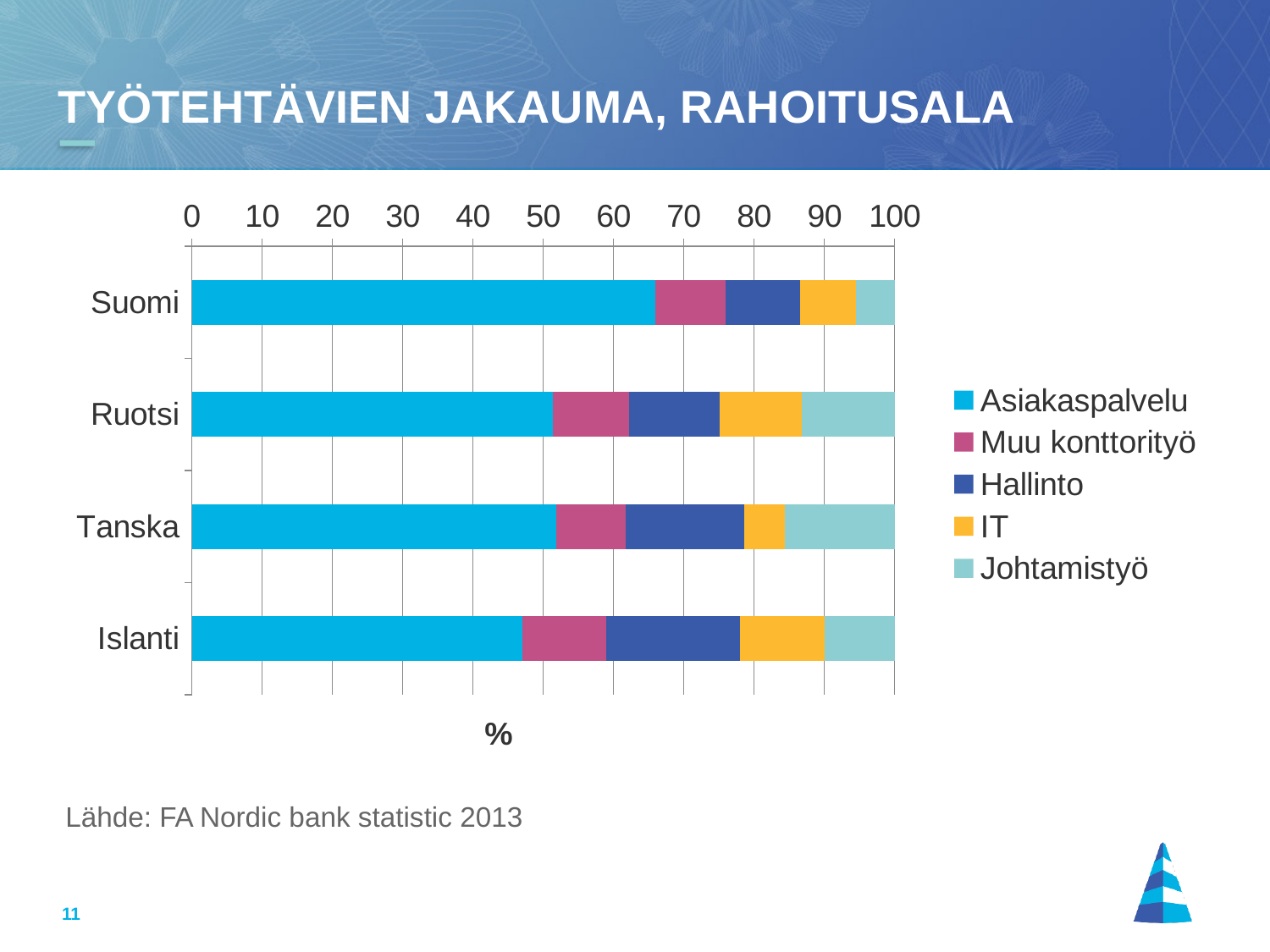
What kind of chart is shown on the slide? stacked bar chart Is the Johtamistyö share for Suomi greater or less than 10? less Which country has the largest Asiakaspalvelu share? Suomi Which country has the smallest Johtamistyö share? Suomi Which has a larger Johtamistyö share, Tanska or Suomi? Tanska Is the Asiakaspalvelu share for Islanti greater or less than 50? less How many countries are shown on the chart? 4 How many series does the legend list? 5 What is the title of the chart? TYÖTEHTÄVIEN JAKAUMA, RAHOITUSALA Is the Asiakaspalvelu share for Suomi greater or less than 60? greater Which has a larger Asiakaspalvelu share, Suomi or Islanti? Suomi What is the label on the horizontal axis? %